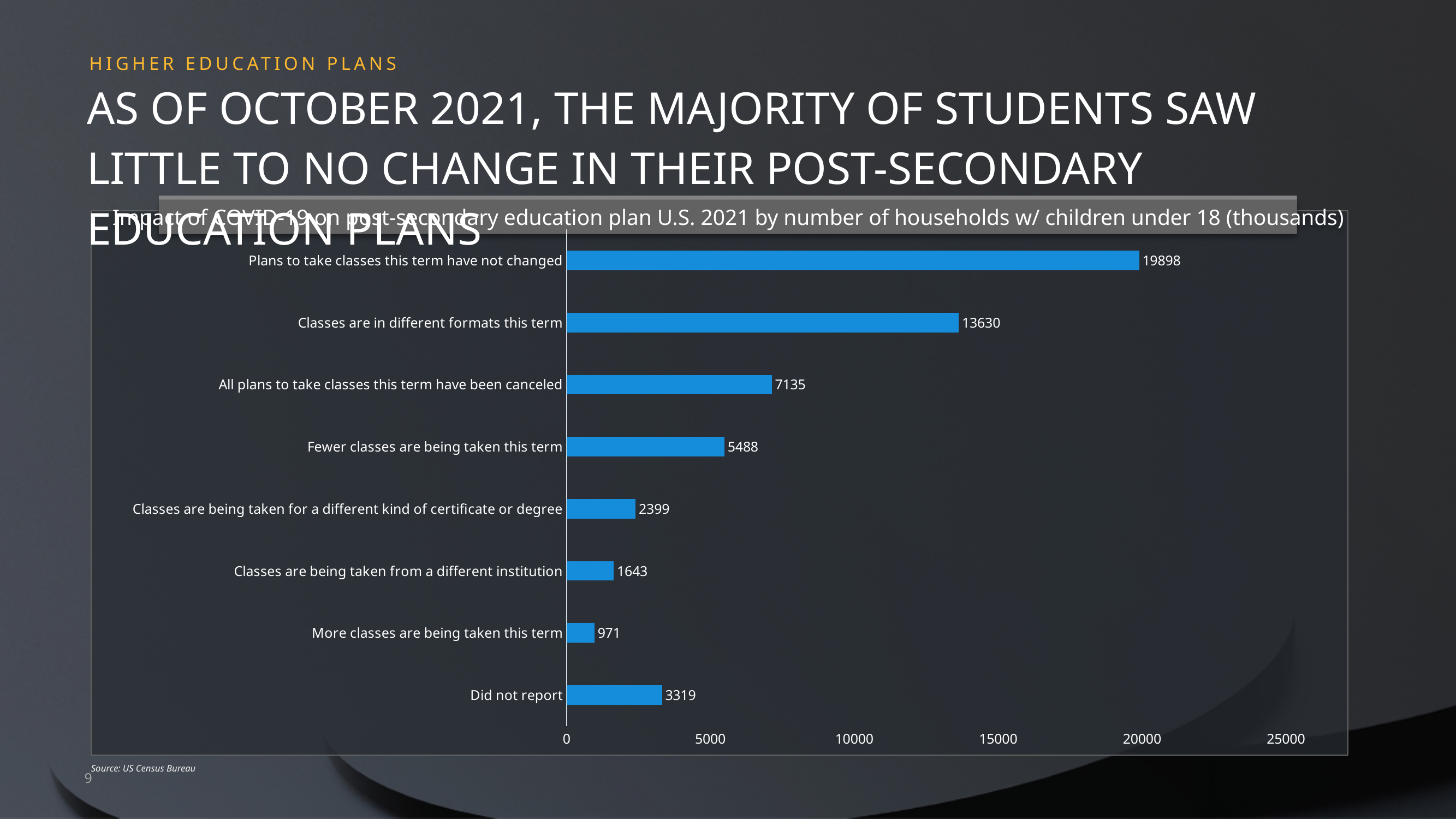
Which category has the lowest value? More classes are being taken this term What is the value for "Plans to take classes this term have not changed"? 19898 Which category has the highest value? Plans to take classes this term have not changed What is the value for "Did not report"? 3319 What is the difference between "All plans to take classes this term have been canceled" and "Fewer classes are being taken this term"? 1647 What is the value for "Classes are being taken from a different institution"? 1643 Which is larger: "Classes are being taken for a different kind of certificate or degree" or "Did not report"? Did not report Is the value for "Classes are in different formats this term" greater or less than 10000? greater How many categories are shown in the chart? 8 What is the source cited below the chart? US Census Bureau What is the value for "Classes are in different formats this term"? 13630 What kind of chart is shown on the slide? Bar chart